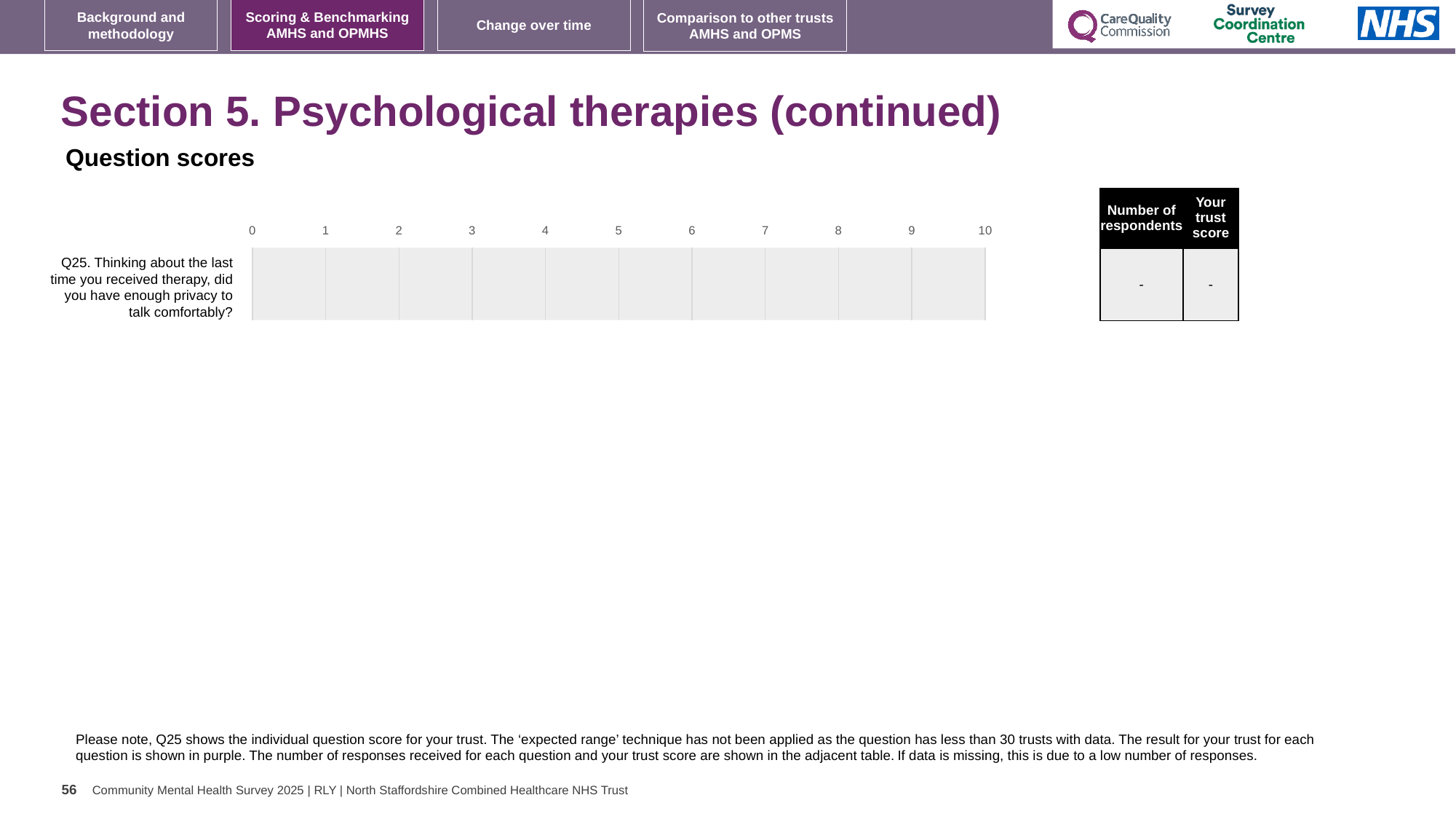
What is the highest value shown on the chart's horizontal axis? 10 What value is shown in the 'Number of respondents' column for Q25? - What kind of chart is used on the slide for the question scores? bar chart How many questions are listed on the chart's vertical axis? 1 What value is shown in the 'Your trust score' column for Q25? - Is a bar plotted for Q25 on the chart? No Which question number is shown on the chart? Q25 What is the lowest value shown on the chart's horizontal axis? 0